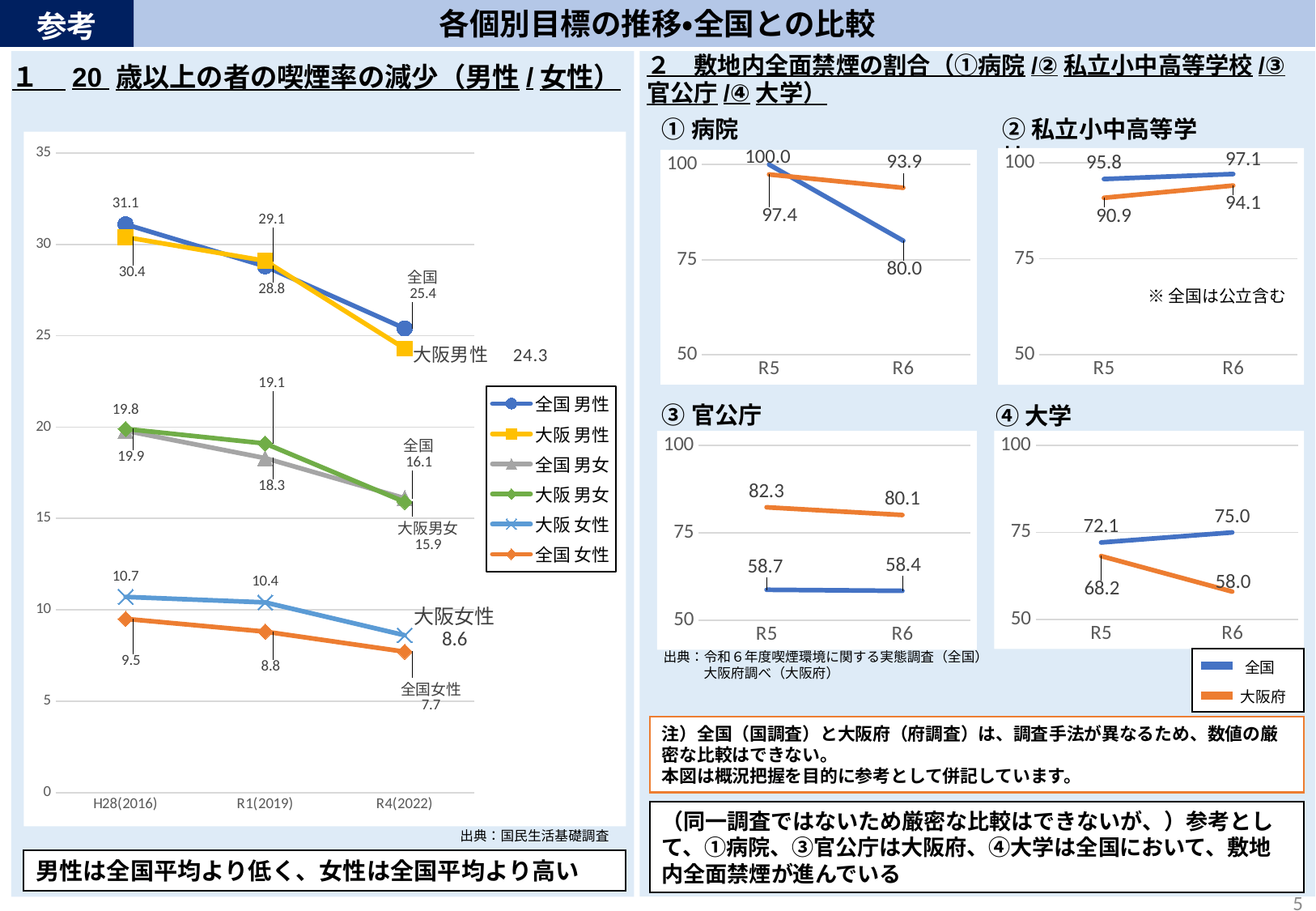
In the left chart (20歳以上の者の喫煙率の減少), does the 全国 女性 series rise or fall from H28(2016) to R4(2022)? fall In the left chart (20歳以上の者の喫煙率の減少), how many series does the legend list? 6 What kind of chart is the ④ 大学 chart? line chart In the ③ 官公庁 chart, which is larger at R6, 全国 or 大阪府? 大阪府 In the left chart (20歳以上の者の喫煙率の減少), what is the difference between 全国 男性 and 大阪 男性 at R4(2022)? 1.1 In the left chart (20歳以上の者の喫煙率の減少), how many points are on the x axis? 3 In the left chart (20歳以上の者の喫煙率の減少), what is the value for 大阪 女性 at R4(2022)? 8.6 In the left chart (20歳以上の者の喫煙率の減少), what is the value for 全国 男性 at H28(2016)? 31.1 In the ② 私立小中高等学校 chart, what is the 大阪府 value at R5? 90.9 In the ① 病院 chart, what is the 全国 value at R6? 80.0 In the ① 病院 chart, what is the difference between the 全国 values at R5 and R6? 20.0 In the ④ 大学 chart, does the 大阪府 series rise or fall from R5 to R6? fall